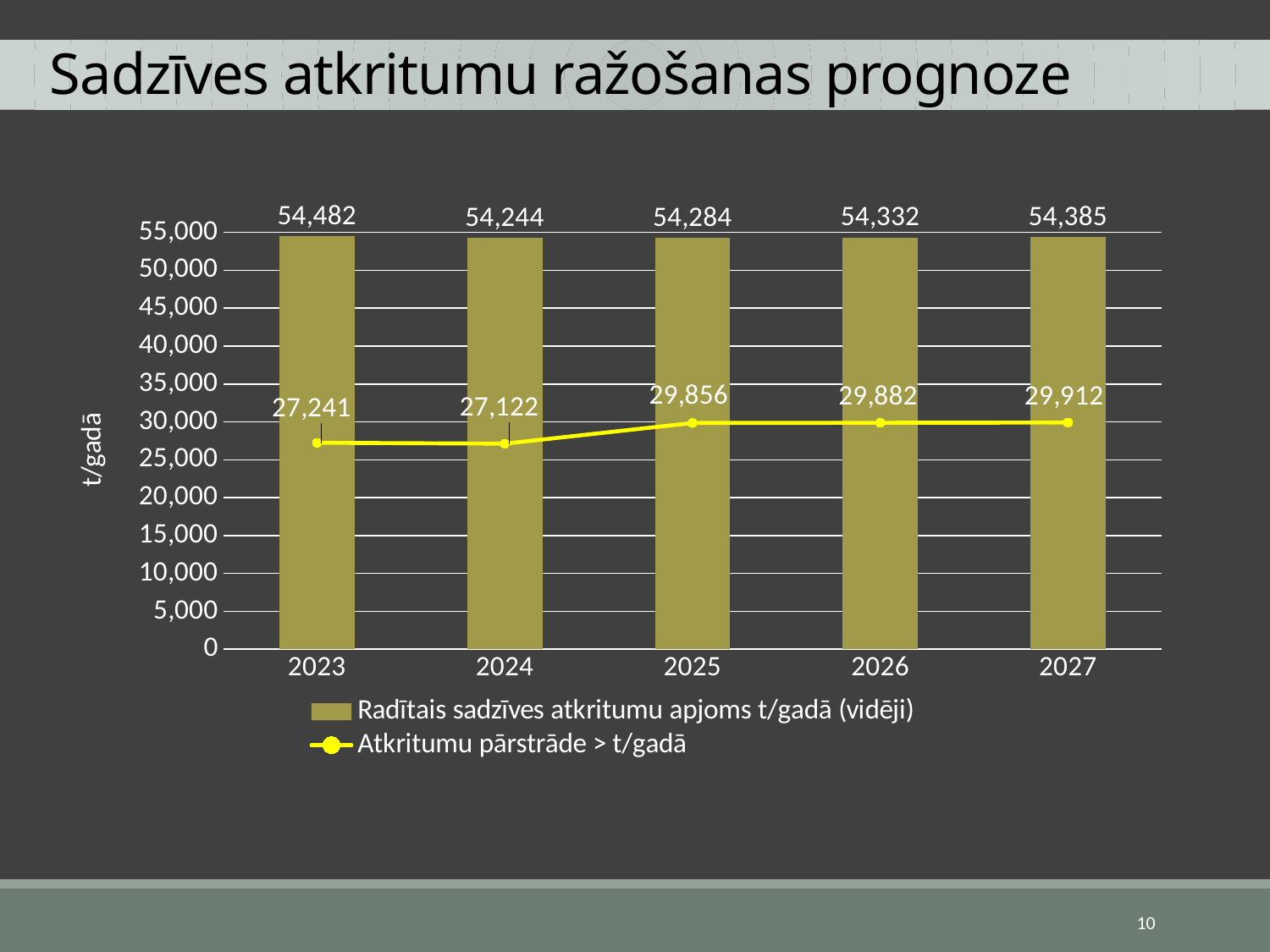
Which year has the lowest value for 'Atkritumu pārstrāde > t/gadā'? 2024 What is the title of the slide? Sadzīves atkritumu ražošanas prognoze Which year has the highest value for 'Radītais sadzīves atkritumu apjoms t/gadā (vidēji)'? 2023 What kind of chart is shown on the slide? Combined bar and line chart How many series does the legend list? 2 What is the difference between 'Radītais sadzīves atkritumu apjoms t/gadā (vidēji)' and 'Atkritumu pārstrāde > t/gadā' in 2026? 24,450 What is the value of 'Atkritumu pārstrāde > t/gadā' for 2025? 29,856 Is the value for 'Atkritumu pārstrāde > t/gadā' in 2025 greater or less than 25,000? greater How many years are shown on the x axis? 5 What is the value of 'Atkritumu pārstrāde > t/gadā' for 2027? 29,912 What is the value of 'Radītais sadzīves atkritumu apjoms t/gadā (vidēji)' for 2023? 54,482 Which is larger: 'Atkritumu pārstrāde > t/gadā' in 2023 or in 2024? 2023